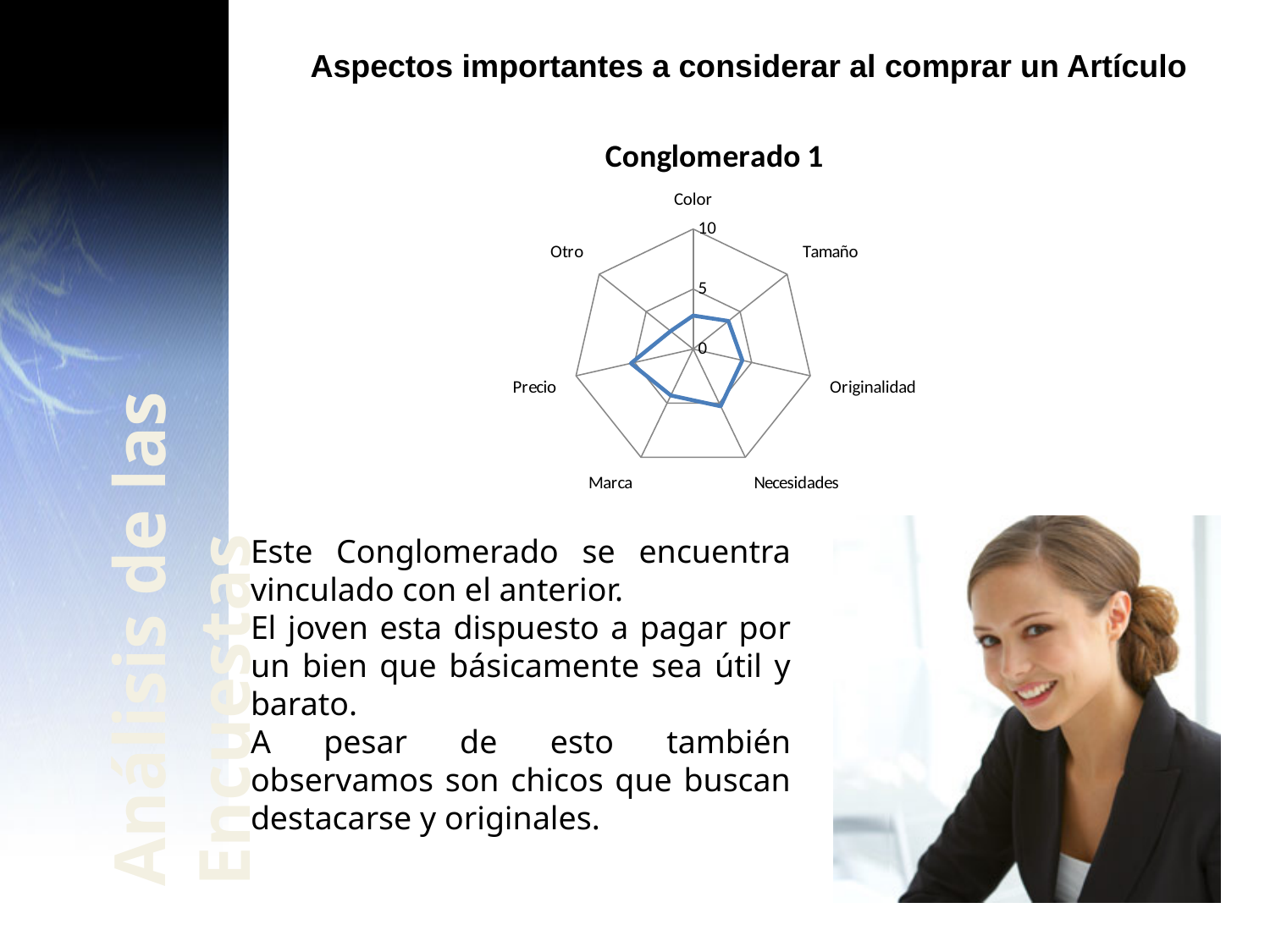
Is the value for Tamaño greater or less than 5? less Is the value for Color greater or less than 5? less What type of chart is shown on the slide? Radar chart What is the title of the chart? Conglomerado 1 Which is larger, the value for Precio or the value for Color? Precio Which is larger, the value for Precio or the value for Originalidad? Precio What is the maximum value shown on the chart's axis scale? 10 How many categories (axes) does the radar chart have? 7 Is the value for Originalidad greater or less than 5? less